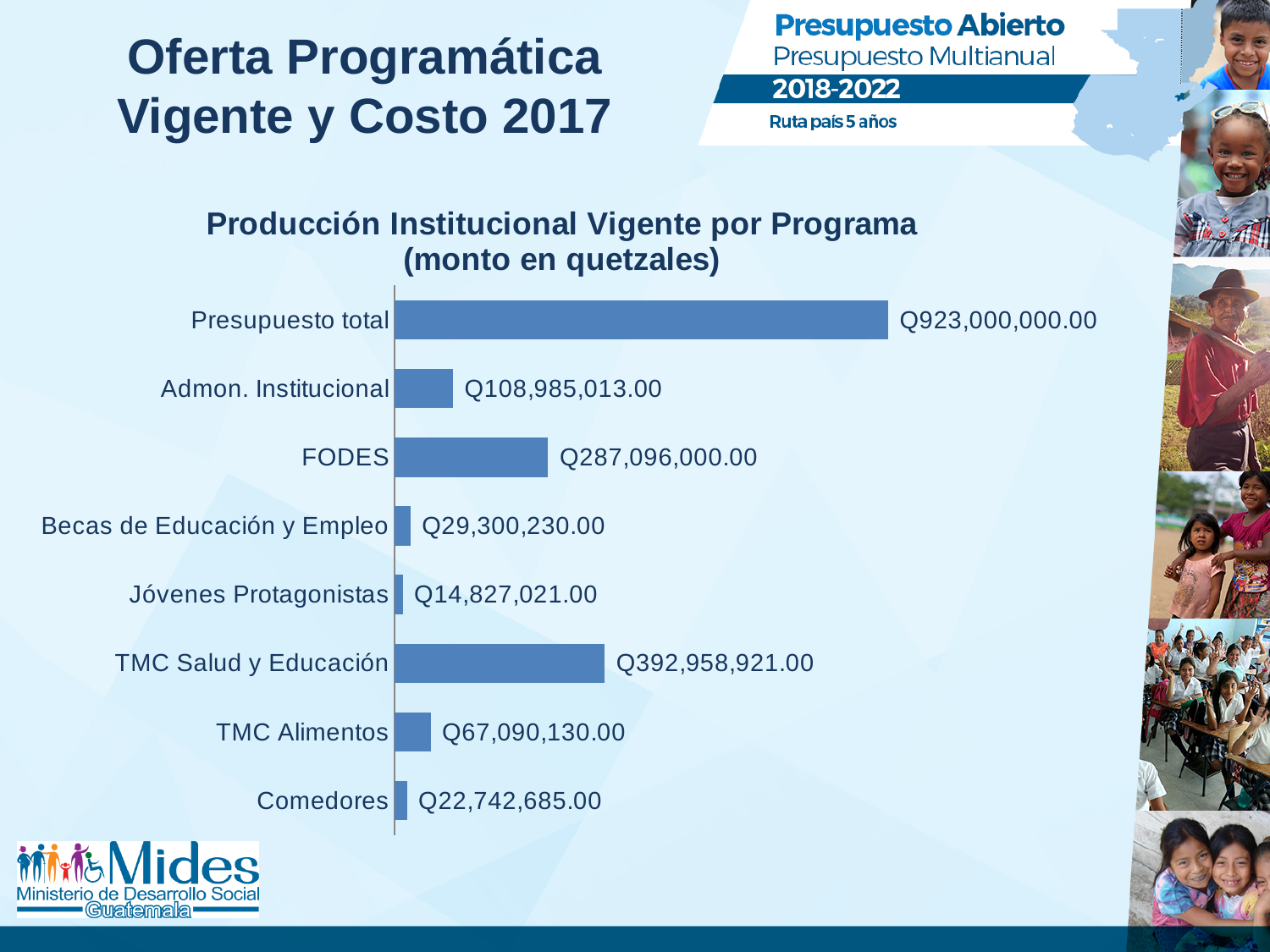
What is the value for TMC Salud y Educación? Q392,958,921.00 What is the difference between TMC Alimentos and Becas de Educación y Empleo? Q37,789,900.00 Which category has the highest value? Presupuesto total How many categories are shown in the chart? 8 Which category has the lowest value? Jóvenes Protagonistas What kind of chart is shown on the slide? Bar chart What is the title of the chart? Producción Institucional Vigente por Programa (monto en quetzales) What is the value for Comedores? Q22,742,685.00 What is the difference between TMC Salud y Educación and FODES? Q105,862,921.00 Which is larger, TMC Alimentos or Becas de Educación y Empleo? TMC Alimentos What is the value for FODES? Q287,096,000.00 What is the value for Admon. Institucional? Q108,985,013.00